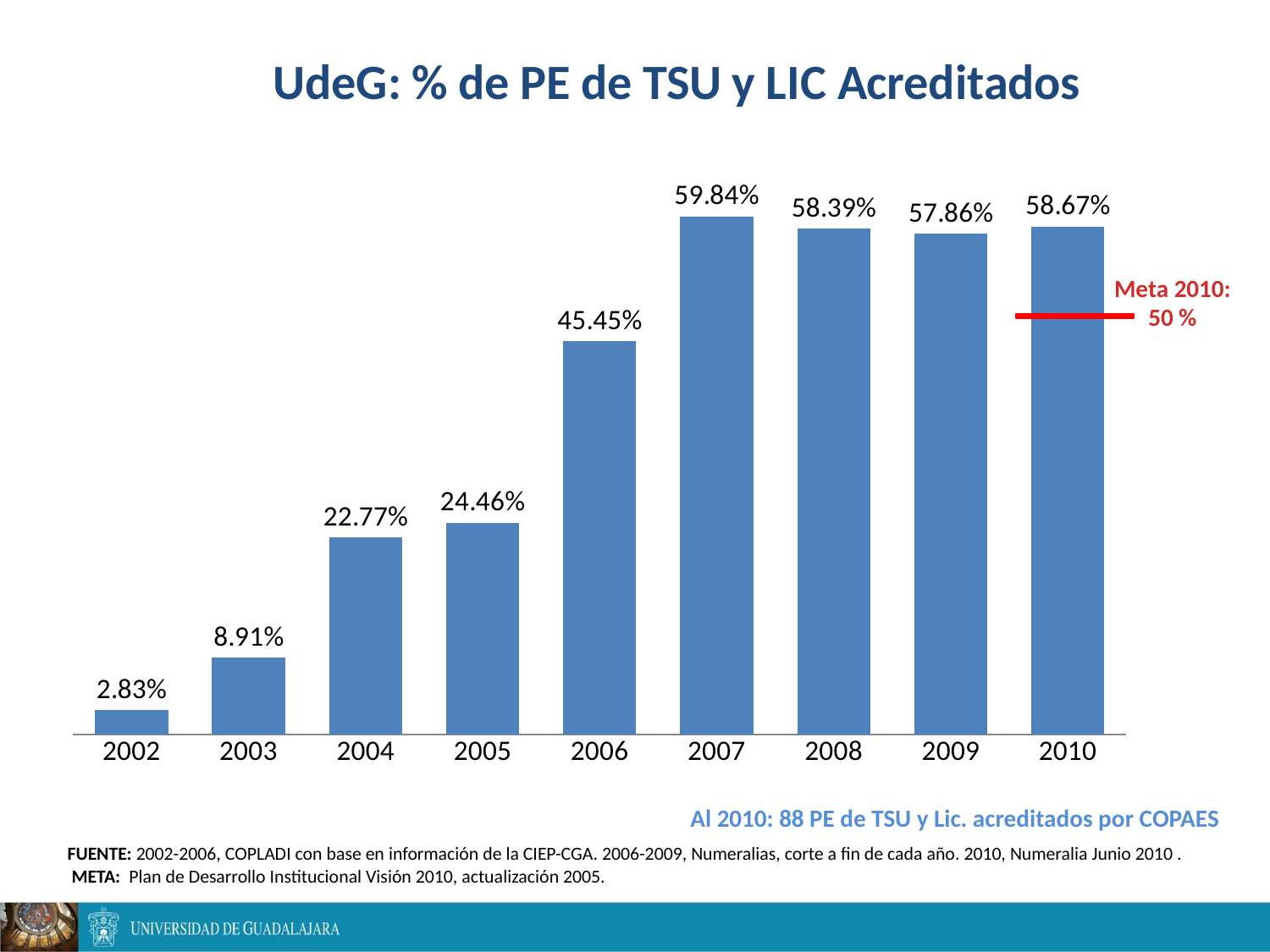
How many years are shown on the x axis? 9 What is the value for 2002? 2.83% Which year has the lowest value? 2002 What is the difference between the values for 2007 and 2006? 14.39% What target value does the red line labelled 'Meta 2010' indicate? 50 % What is the difference between the values for 2005 and 2004? 1.69% Which year has the highest value? 2007 What kind of chart is this? bar chart What is the value for 2010? 58.67% Do the values generally rise or fall from 2002 to 2007? rise Which is larger, the value for 2008 or the value for 2009? 2008 What is the value for 2006? 45.45%